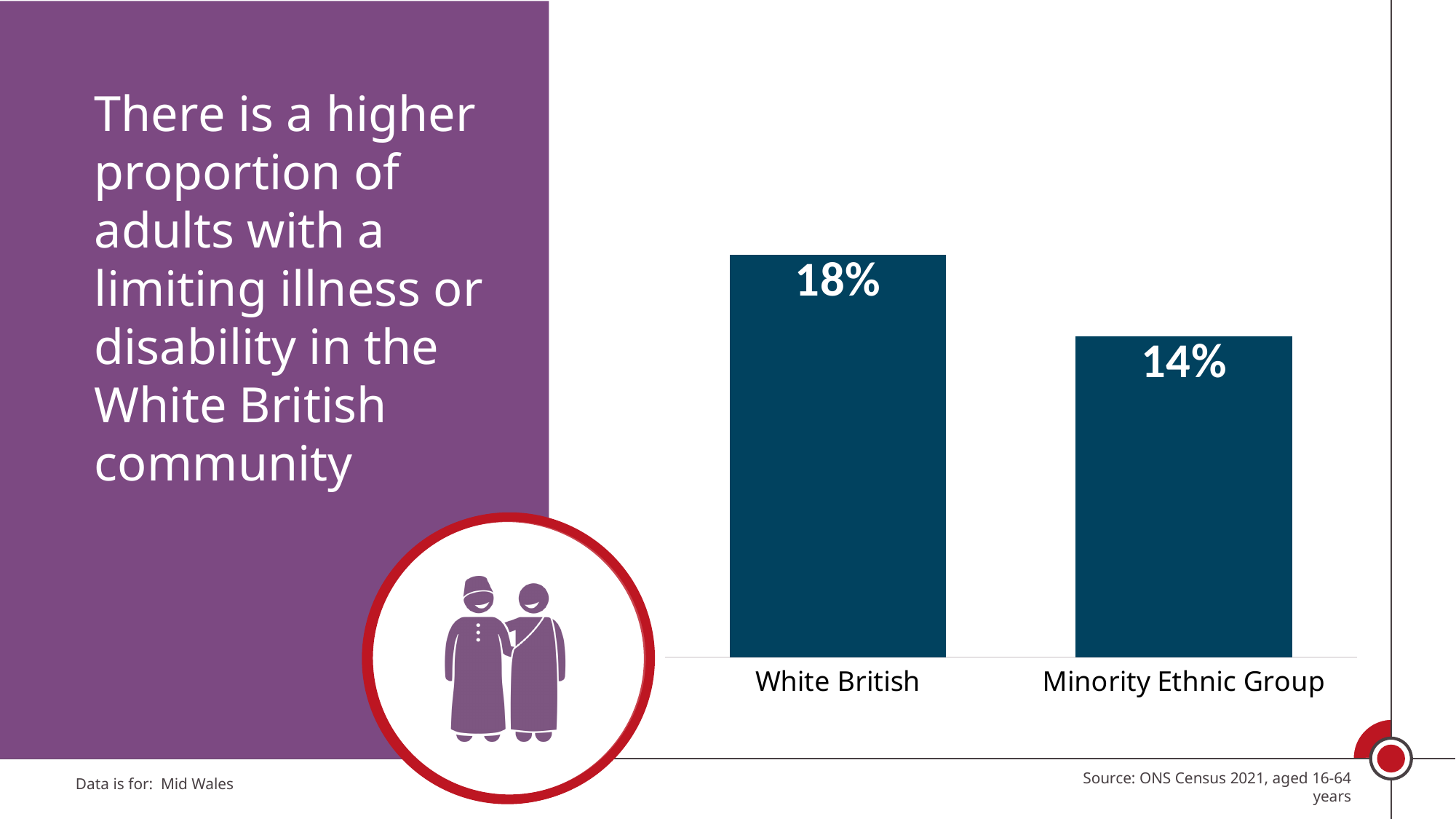
What kind of chart is shown on the slide? Bar chart Which category has the highest value? White British How many categories are shown in the chart? 2 What is the value for Minority Ethnic Group? 14% What is the value for White British? 18% What is the difference between the values for White British and Minority Ethnic Group? 4% What is the source of the data shown in the chart? ONS Census 2021, aged 16-64 years What colour are the bars in the chart? Dark blue Do the values rise or fall from left to right across the categories? Fall Which category has the lowest value? Minority Ethnic Group Which is larger, the value for White British or the value for Minority Ethnic Group? White British